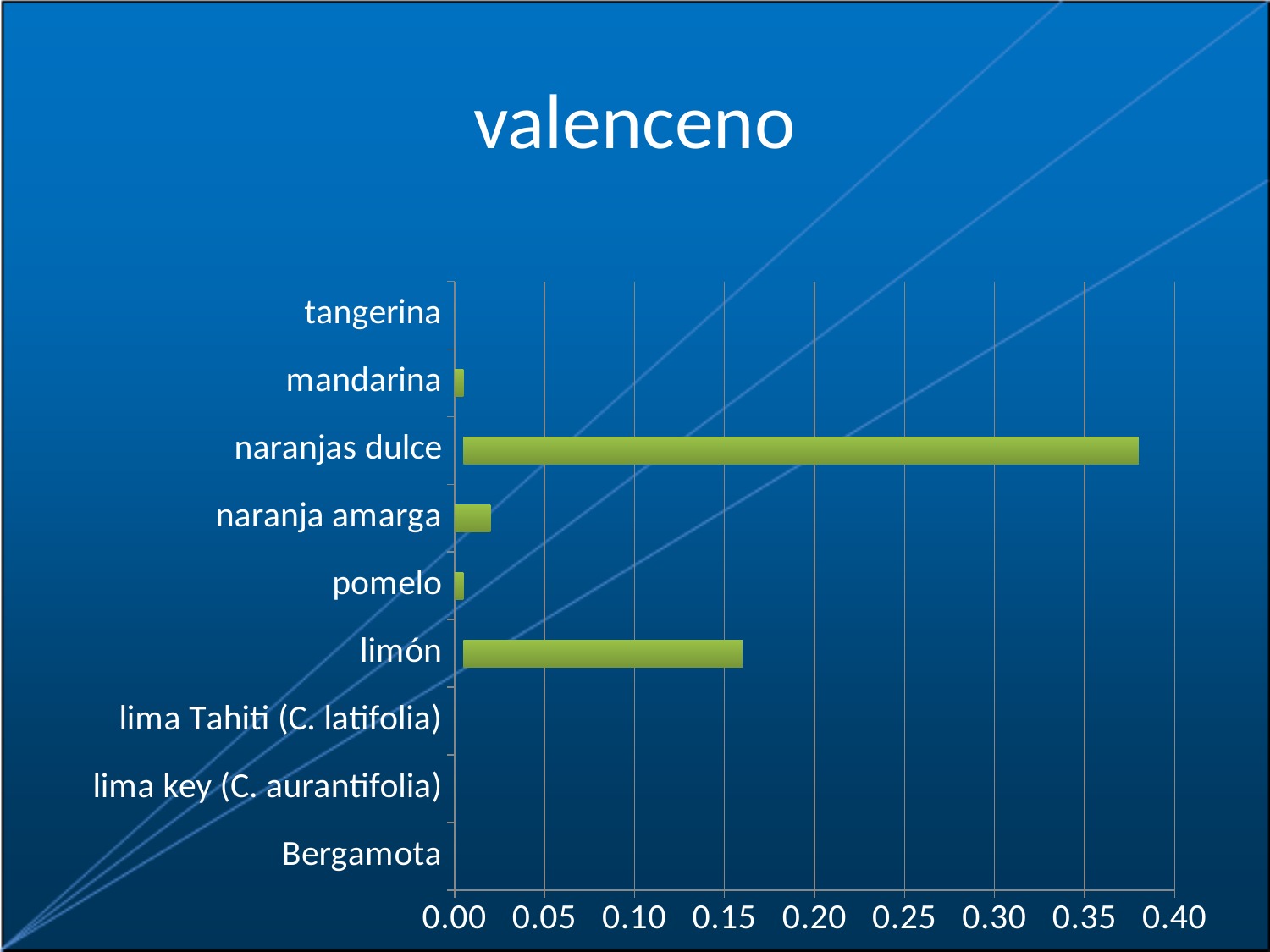
What is the title of the chart? valenceno What is the highest tick value shown on the horizontal axis? 0.40 How many categories are listed on the vertical axis of the chart? 9 Is the value for limón greater or less than 0.10? greater Which category has the second-longest bar in the chart? limón Which has a larger value, naranjas dulce or limón? naranjas dulce Is the value for naranja amarga greater or less than 0.05? less Which category has the highest value in the chart? naranjas dulce Which has a larger value, limón or naranja amarga? limón Is the value for limón greater or less than 0.20? less What kind of chart is shown on the slide? bar chart